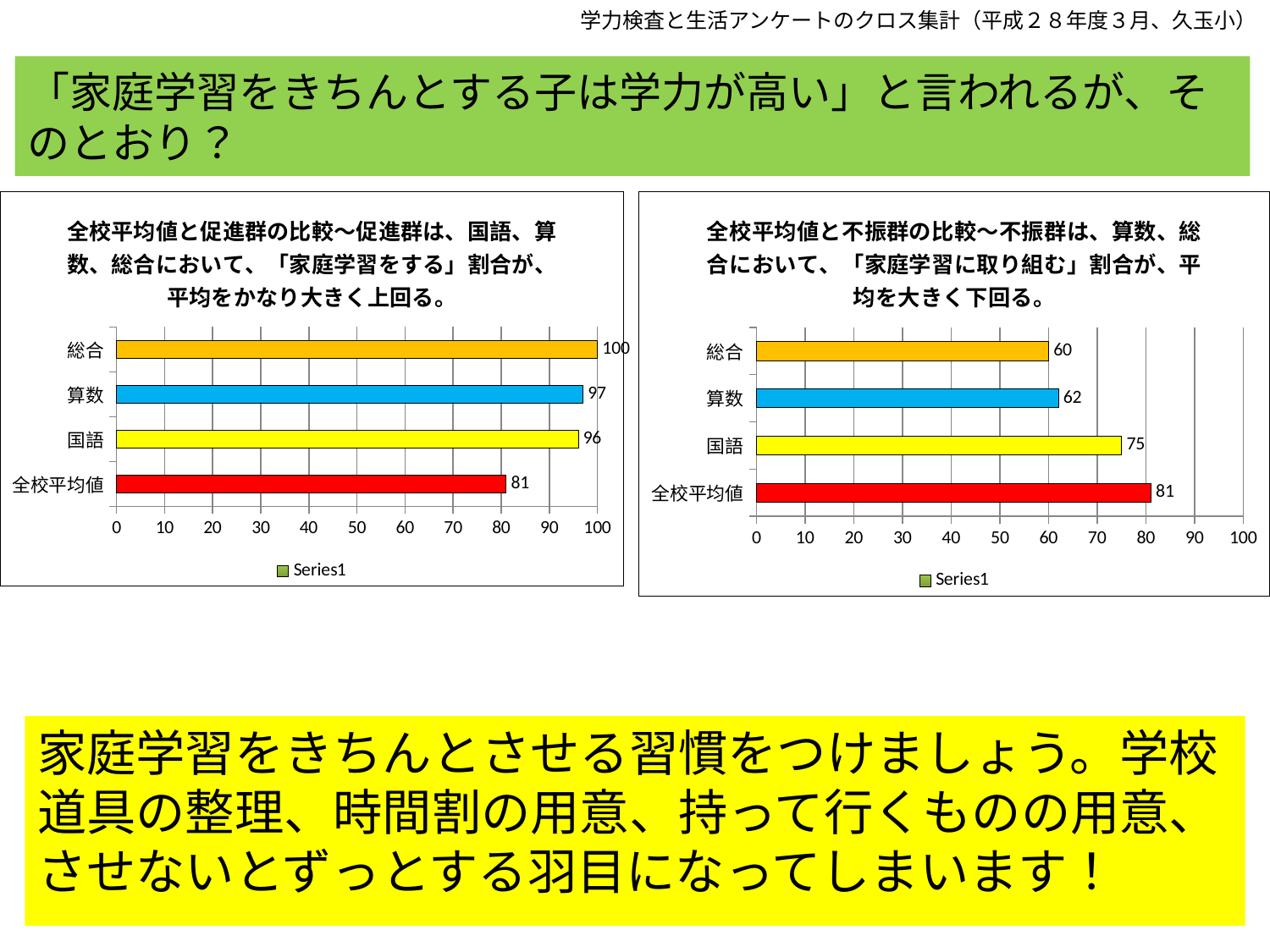
In the left chart (全校平均値と促進群の比較), which category has the lowest value? 全校平均値 In the right chart (全校平均値と不振群の比較), what is the value for 総合? 60 What type of chart is the right chart (全校平均値と不振群の比較)? bar chart In the left chart (全校平均値と促進群の比較), what is the value for 総合? 100 In the right chart (全校平均値と不振群の比較), which category has the lowest value? 総合 In the right chart (全校平均値と不振群の比較), what is the difference between 全校平均値 and 算数? 19 In the right chart (全校平均値と不振群の比較), which category has the highest value? 全校平均値 In the right chart (全校平均値と不振群の比較), what is the value for 国語? 75 How many categories are shown in the left chart (全校平均値と促進群の比較)? 4 In the left chart (全校平均値と促進群の比較), what is the value for 算数? 97 In the right chart (全校平均値と不振群の比較), which is larger, 国語 or 算数? 国語 In the left chart (全校平均値と促進群の比較), what is the difference between 国語 and 全校平均値? 15